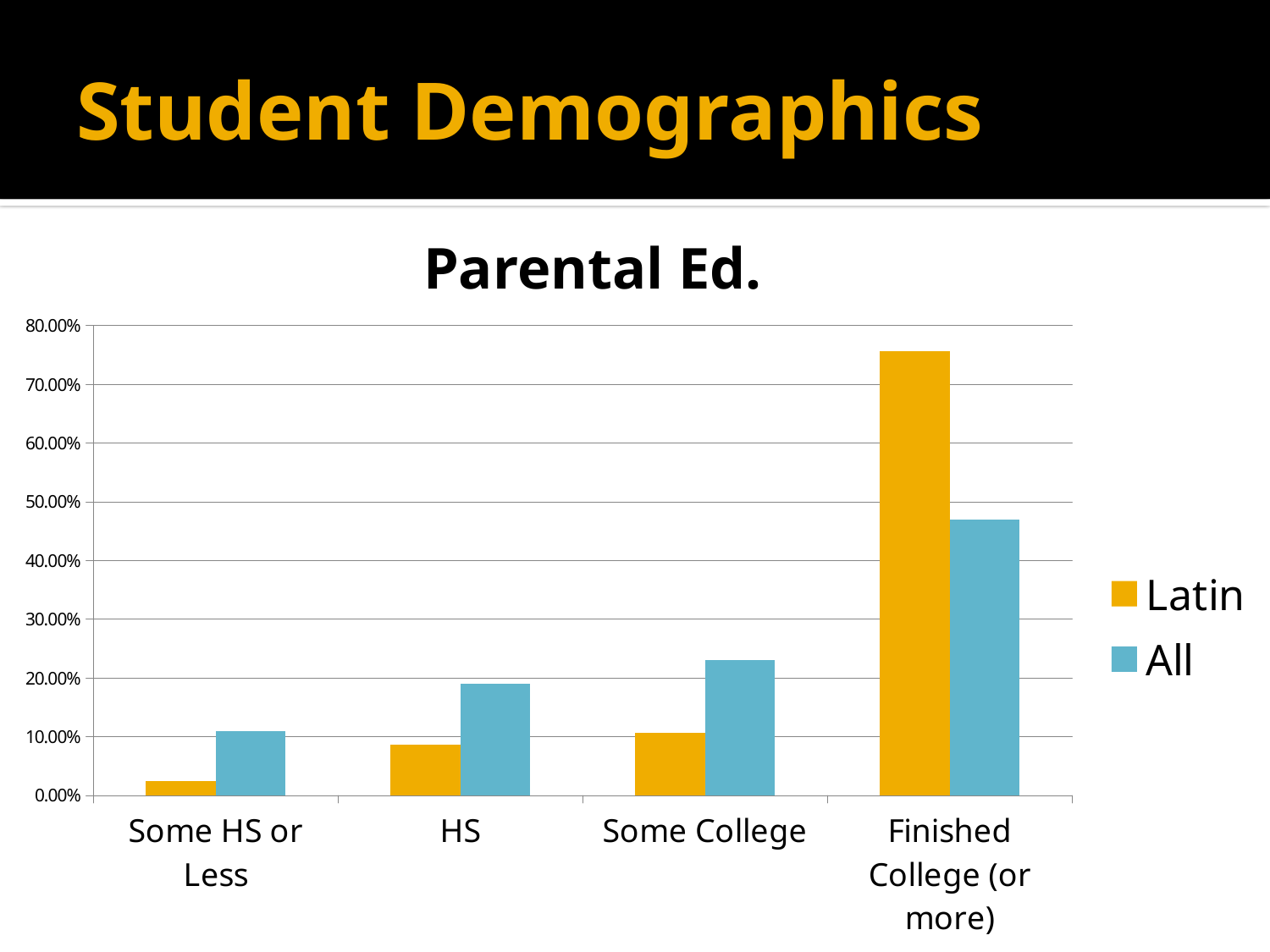
Which category has the highest value for the Latin series? Finished College (or more) What kind of chart is shown on the slide? bar chart For Some College, which series has the larger value, Latin or All? All What is the title of the chart? Parental Ed. Is the All value for Some College greater or less than 20.00%? greater How many parental education categories are shown on the x axis? 4 Do the Latin values rise or fall moving from Some HS or Less to Finished College (or more)? rise Is the All value for Finished College (or more) greater or less than 50.00%? less Which category has the lowest value for the Latin series? Some HS or Less Is the Latin value for Finished College (or more) greater or less than 70.00%? greater How many series does the legend list? 2